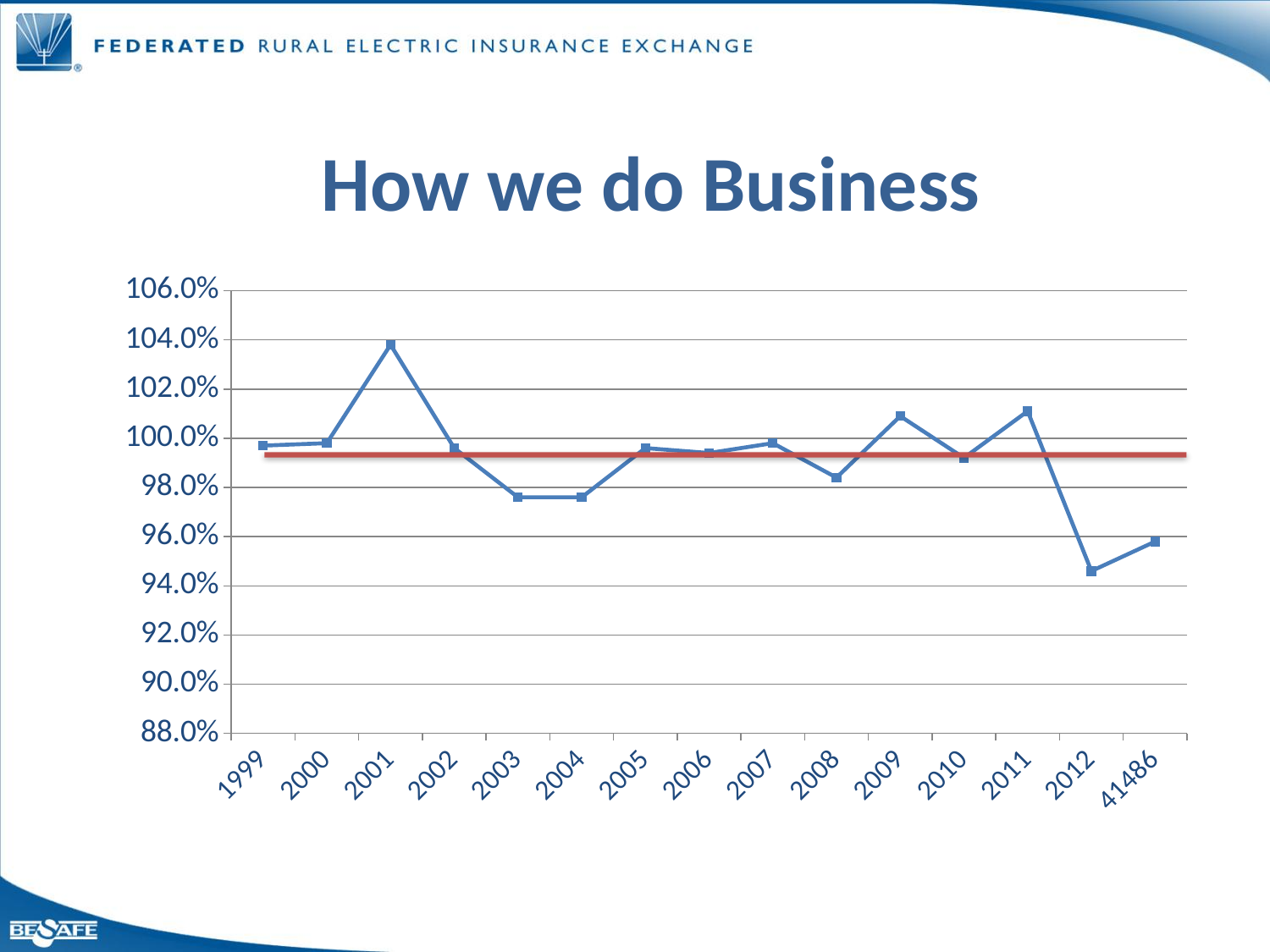
Which is larger, the value for 2001 or the value for 2012? 2001 What is the title of the slide containing the chart? How we do Business Which year has the lowest value on the blue line? 2012 Is the value for 2012 greater or less than 96.0%? less How many categories are shown along the x axis of the chart? 15 Is the value for 2009 greater or less than 100.0%? greater Is the value for 2001 greater or less than 102.0%? greater Does the blue line rise or fall from 2011 to 2012? fall Which year has the highest value on the blue line? 2001 What kind of chart is shown on the slide? line chart Which is larger, the value for 2003 or the value for 2005? 2005